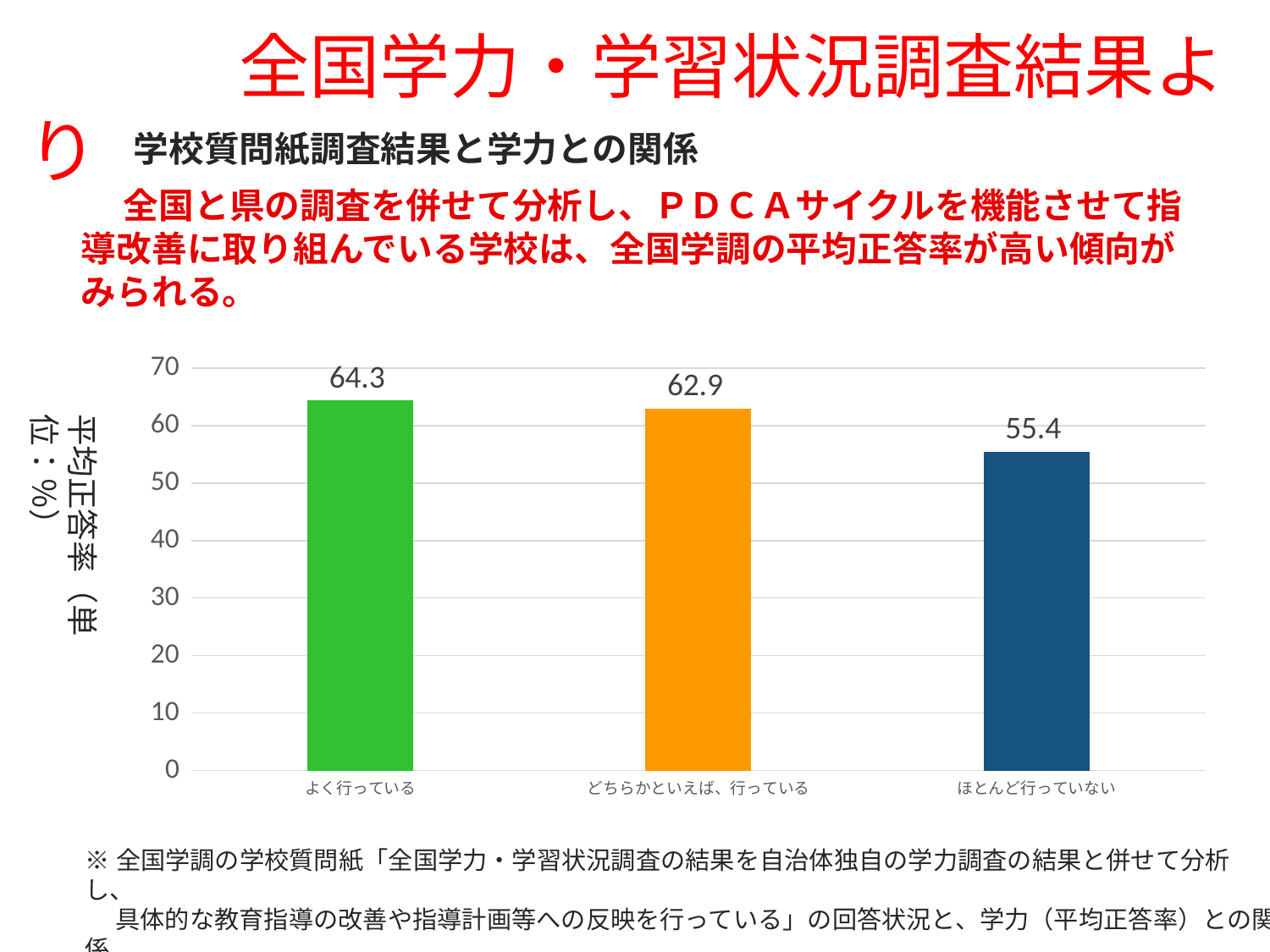
Which category has the highest value? よく行っている What is the value for よく行っている? 64.3 What is the value for どちらかといえば、行っている? 62.9 How many categories are shown on the x axis? 3 Which is larger, the value for どちらかといえば、行っている or the value for ほとんど行っていない? どちらかといえば、行っている What is the value for ほとんど行っていない? 55.4 What is the difference between the values for よく行っている and ほとんど行っていない? 8.9 Is the value for ほとんど行っていない greater or less than 60? less What is the difference between the values for どちらかといえば、行っている and ほとんど行っていない? 7.5 What kind of chart is shown on the slide? bar chart Do the values rise or fall from left to right along the x axis? fall Which category has the lowest value? ほとんど行っていない